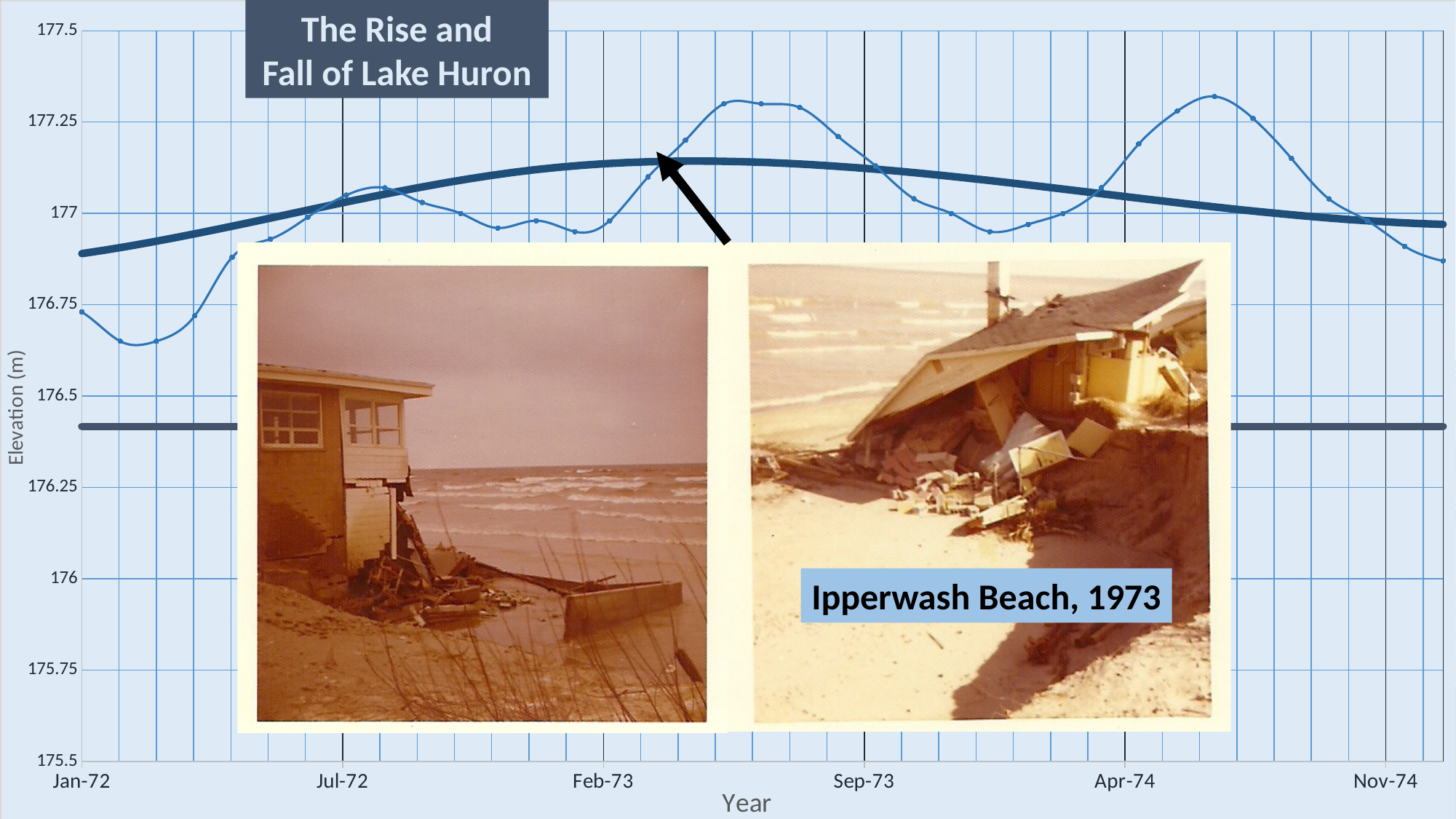
Does the monthly elevation line rise or fall between Jan-72 and Jul-72? rise What is the highest value shown on the vertical axis of the chart? 177.5 Is the elevation value for Sep-73 greater or less than 177? greater Does the monthly elevation line rise or fall between Sep-73 and the start of 1974? fall Which has the higher elevation value, Jan-72 or Sep-73? Sep-73 Is the peak of the monthly elevation line in mid-1974 greater or less than 177.25? greater What is the label of the vertical axis of the chart? Elevation (m) What is the title of the chart? The Rise and Fall of Lake Huron Is the elevation value for Jan-72 greater or less than 177? less How many labelled tick marks are shown on the x axis of the chart? 6 What kind of chart is shown on the slide? line chart